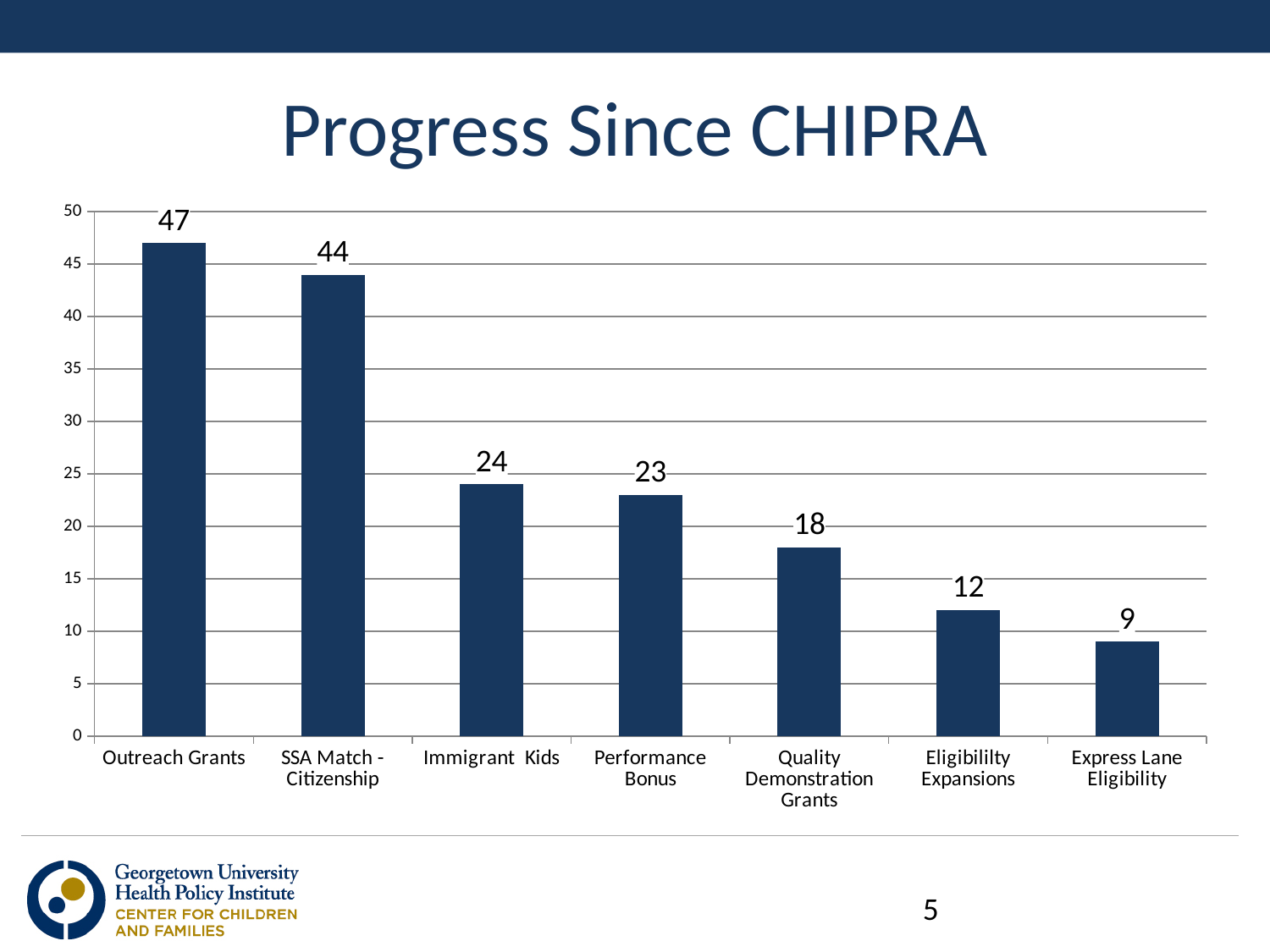
Is the value for SSA Match - Citizenship greater or less than 40? greater What is the difference between the values for Immigrant Kids and Eligibililty Expansions? 12 Which category has the highest value? Outreach Grants Which category has the lowest value? Express Lane Eligibility What is the value for Express Lane Eligibility? 9 How many categories are shown on the chart? 7 What is the value for Quality Demonstration Grants? 18 What is the difference between the values for Outreach Grants and SSA Match - Citizenship? 3 What kind of chart is shown on the slide? bar chart Which is larger, the value for Performance Bonus or the value for Quality Demonstration Grants? Performance Bonus What is the value for Outreach Grants? 47 What is the title of the chart? Progress Since CHIPRA